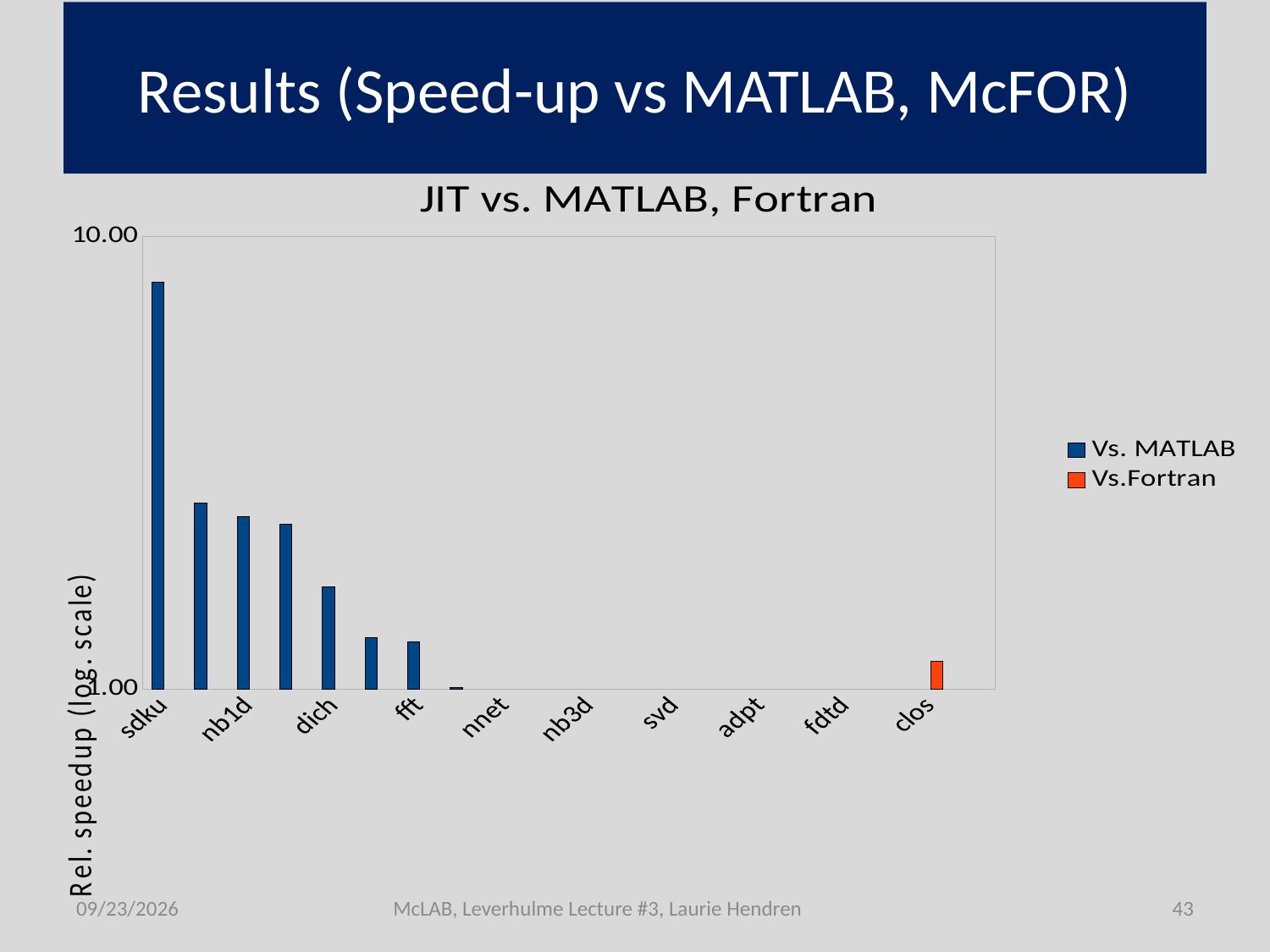
What kind of chart is shown on the slide? bar chart Which category has the highest speedup vs. MATLAB? sdku How many category labels are shown on the x axis? 10 Which has a larger speedup vs. MATLAB, sdku or nb1d? sdku How many series does the legend list? 2 Is the speedup vs. MATLAB for sdku greater or less than 10.00? less Which category has a Vs.Fortran bar? clos Is the speedup vs. MATLAB for dich greater or less than 1.00? greater Which series is shown in orange in the legend? Vs.Fortran What is the title of the chart? JIT vs. MATLAB, Fortran Do the Vs. MATLAB bars rise or fall from left to right along the x axis? fall Which has a larger speedup vs. MATLAB, dich or fft? dich